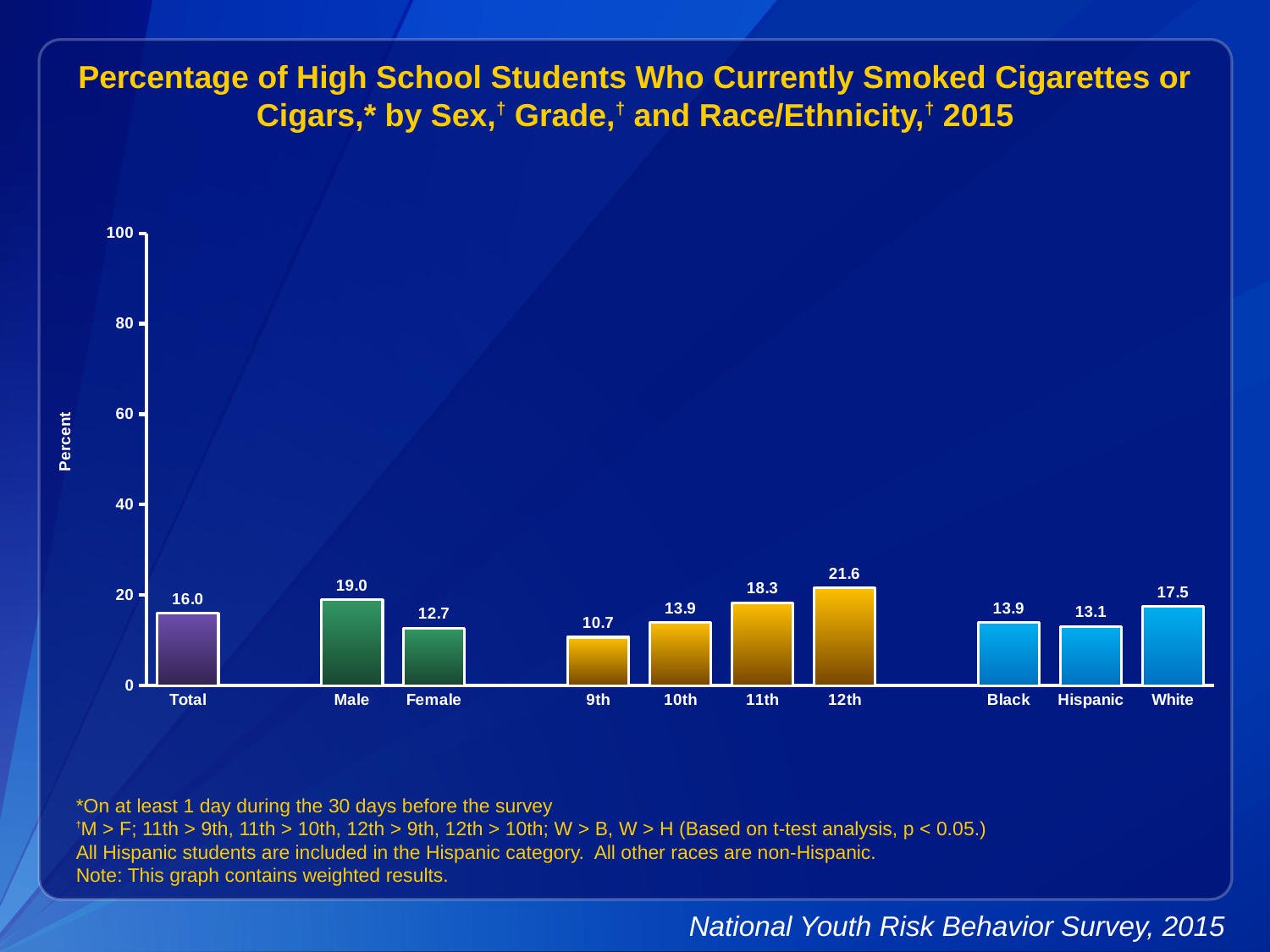
What is the value for Hispanic? 13.1 What is the value for Total? 16.0 Which category has the lowest value? 9th How many categories are shown on the x axis? 10 What kind of chart is this? bar chart Which category has the highest value? 12th Do the values rise or fall from 9th grade to 12th grade? rise Is the value for 11th grade greater or less than 20? less What is the difference between the Male and Female values? 6.3 What is the value for 12th grade? 21.6 What is the value for Male? 19.0 Which is larger, the value for White or the value for Black? White